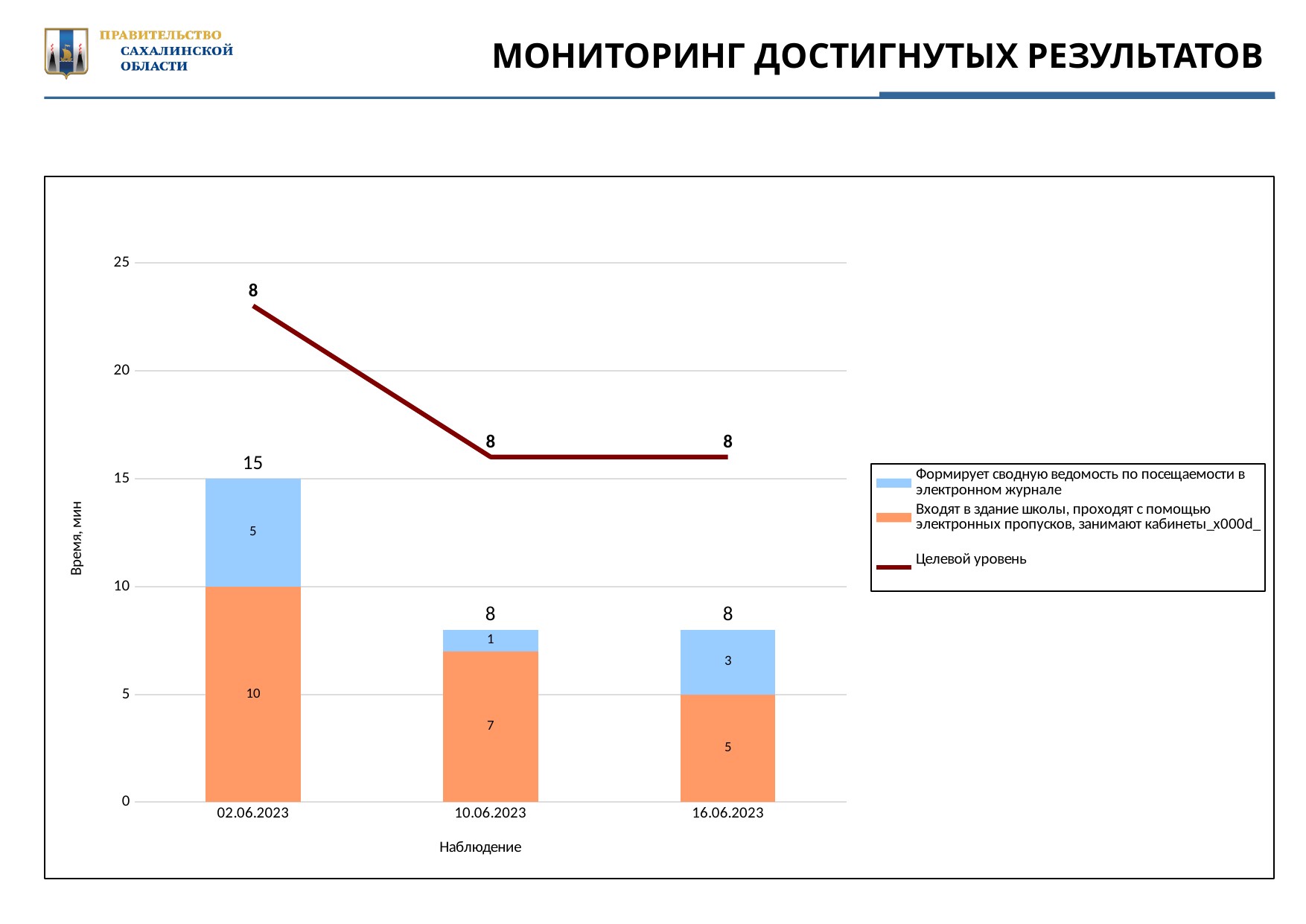
What is the value of the blue series (Формирует сводную ведомость по посещаемости в электронном журнале) for 16.06.2023? 3 What is the total of the stacked bar for 10.06.2023? 8 What is the difference between the orange series values for 02.06.2023 and 16.06.2023? 5 What kind of chart is shown on the slide? Stacked bar chart with a line How many observation dates are shown on the x axis? 3 Which observation date has the highest stacked bar total? 02.06.2023 What is the label on the vertical axis? Время, мин What is the total of the stacked bar for 02.06.2023? 15 Which is larger: the orange series value for 10.06.2023 or the orange series value for 16.06.2023? 10.06.2023 How many entries does the legend list? 3 What is the value of the blue series (Формирует сводную ведомость по посещаемости в электронном журнале) for 10.06.2023? 1 What is the value of the orange series (Входят в здание школы, проходят с помощью электронных пропусков, занимают кабинеты) for 02.06.2023? 10